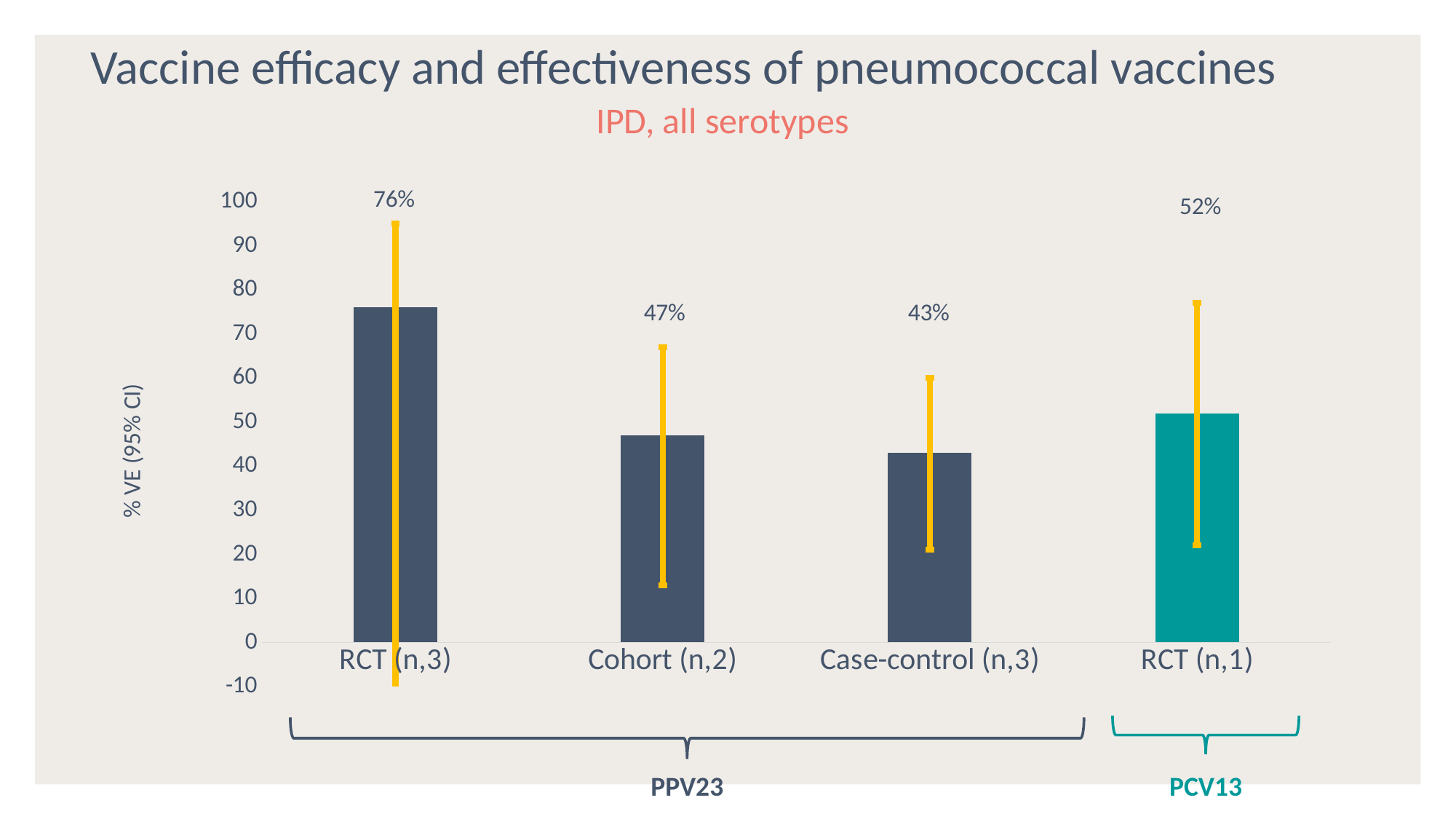
Which category has the highest value? RCT (n,3) What is the subtitle shown in red below the chart title? IPD, all serotypes What is the value shown for Case-control (n,3)? 43% What is the value shown for RCT (n,1) under PCV13? 52% What is the value shown for Cohort (n,2)? 47% What is the difference between the values for RCT (n,3) and Cohort (n,2)? 29% What kind of chart is shown on the slide? Bar chart Which is larger, the value for Cohort (n,2) or the value for RCT (n,1)? RCT (n,1) How many bars are plotted on the chart? 4 What is the difference between the values for RCT (n,1) and Case-control (n,3)? 9% Which category has the lowest value? Case-control (n,3) What is the vaccine effectiveness value shown for RCT (n,3)? 76%